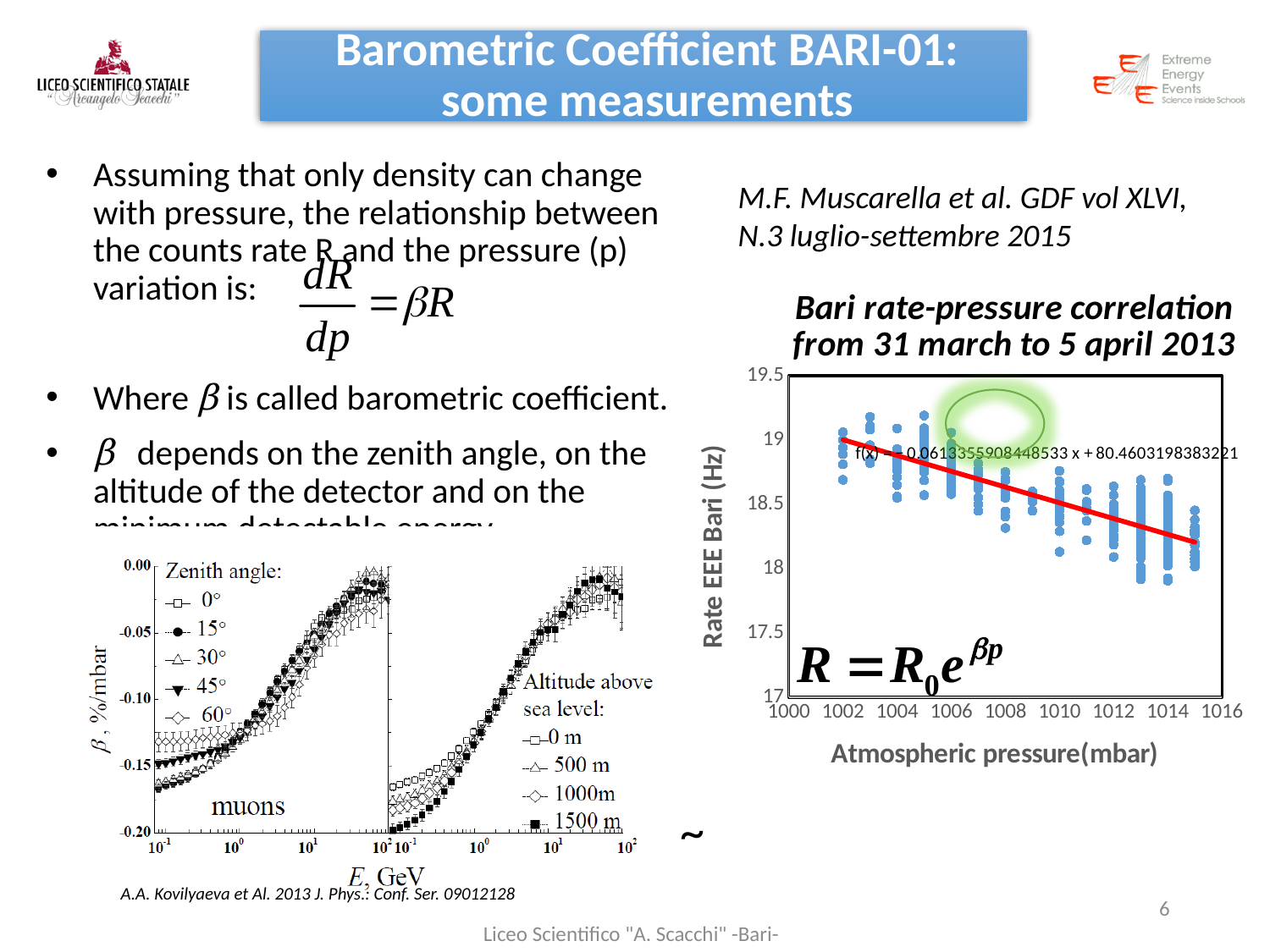
In the 'Bari rate-pressure correlation' chart, what is the intercept of the fitted line f(x)? 80.4603198383221 In the 'Bari rate-pressure correlation' chart, are the rate values at 1015 mbar greater or less than 18.5 Hz? less What kind of chart is the 'Bari rate-pressure correlation from 31 march to 5 april 2013' chart on the right? scatter chart In the 'Bari rate-pressure correlation' chart, does the rate rise or fall as atmospheric pressure increases? fall In the 'Bari rate-pressure correlation' chart, what is the label of the vertical axis? Rate EEE Bari (Hz) In the 'Bari rate-pressure correlation' chart, what is the highest value shown on the vertical axis? 19.5 In the bottom-left chart from Kovilyaeva et al., how many altitude above sea level series are listed in the legend? 4 In the 'Bari rate-pressure correlation' chart, are the rate values at 1002 mbar greater or less than 18.5 Hz? greater In the 'Bari rate-pressure correlation' chart, what is the slope of the fitted line f(x)? -0.0613355908448533 In the 'Bari rate-pressure correlation' chart, what is the label of the horizontal axis? Atmospheric pressure(mbar) In the bottom-left chart from Kovilyaeva et al., does the barometric coefficient β rise or fall as the energy E increases? rise In the bottom-left chart from Kovilyaeva et al., how many zenith angle series are listed in the legend? 5